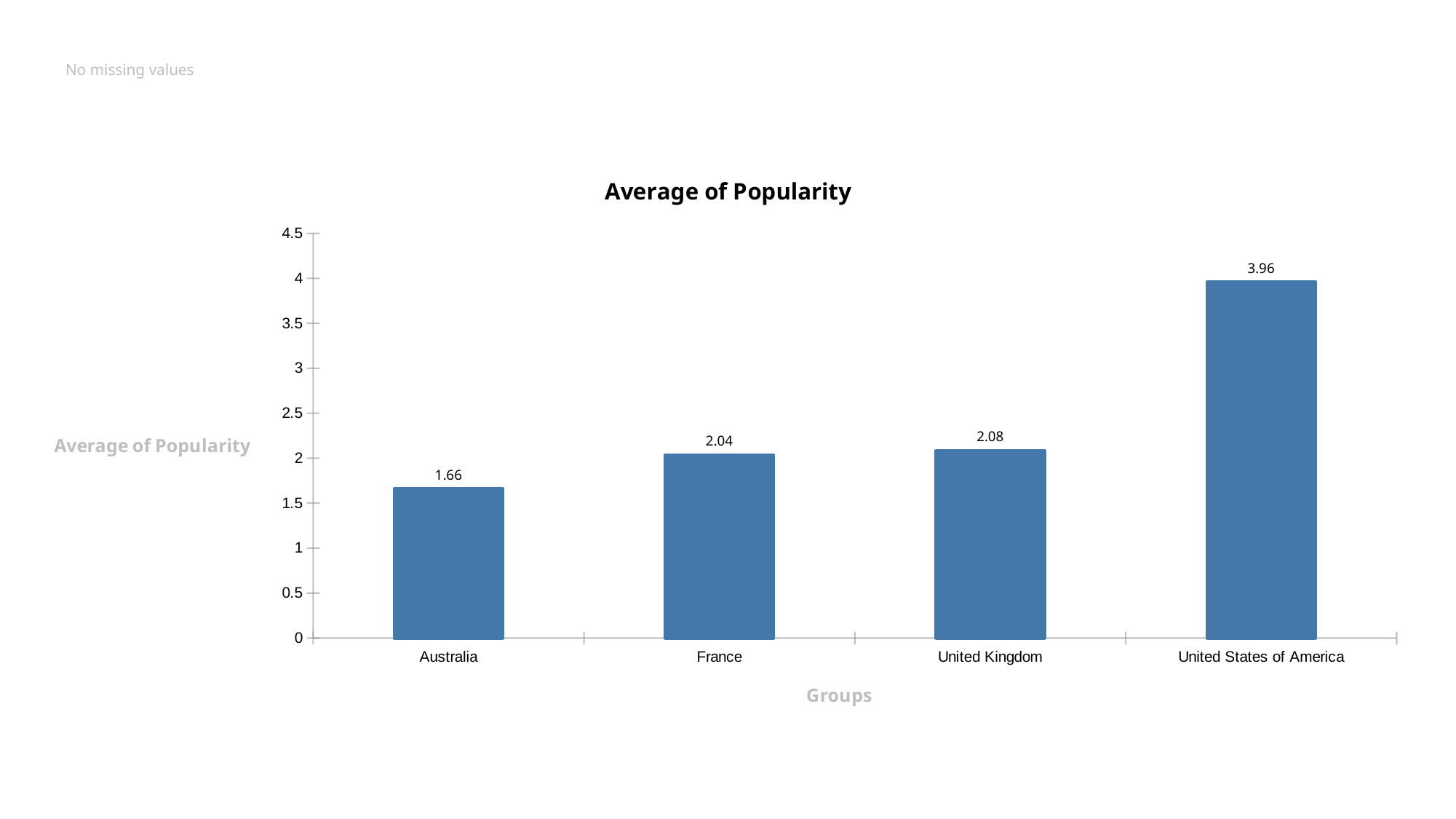
Which has a higher average popularity, France or the United States of America? United States of America What is the average popularity value for Australia? 1.66 What is the average popularity value for the United Kingdom? 2.08 How many groups are shown on the x axis? 4 What is the difference between the average popularity of the United States of America and Australia? 2.30 What is the average popularity value for the United States of America? 3.96 Which group has the lowest average popularity? Australia What is the title of the chart? Average of Popularity What is the difference between the average popularity of the United Kingdom and France? 0.04 What is the average popularity value for France? 2.04 Which group has the highest average popularity? United States of America What kind of chart is shown on the slide? Bar chart